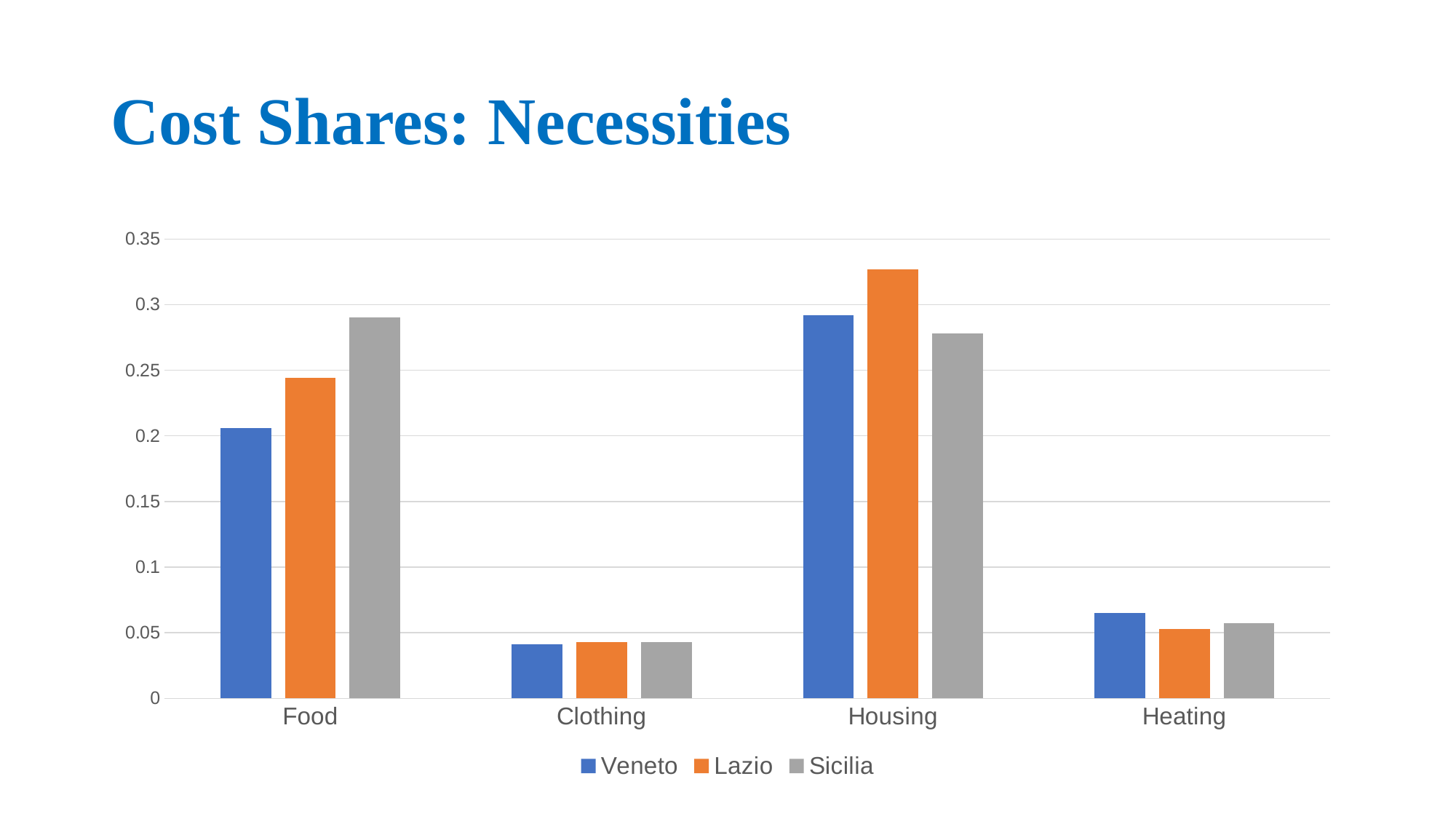
For Housing, which is larger: the value for Lazio or the value for Sicilia? Lazio Which category has the lowest value for Veneto? Clothing Is the value for Veneto in Food greater or less than 0.25? less How many series does the legend list? 3 What is the title of the slide? Cost Shares: Necessities Which category has the highest value for Lazio? Housing Which series has the highest value for Food? Sicilia Is the value for Sicilia in Food greater or less than 0.25? greater How many categories are shown on the x axis? 4 Is the value for Lazio in Housing greater or less than 0.3? greater What kind of chart is shown on the slide? bar chart For Food, which is larger: the value for Sicilia or the value for Veneto? Sicilia